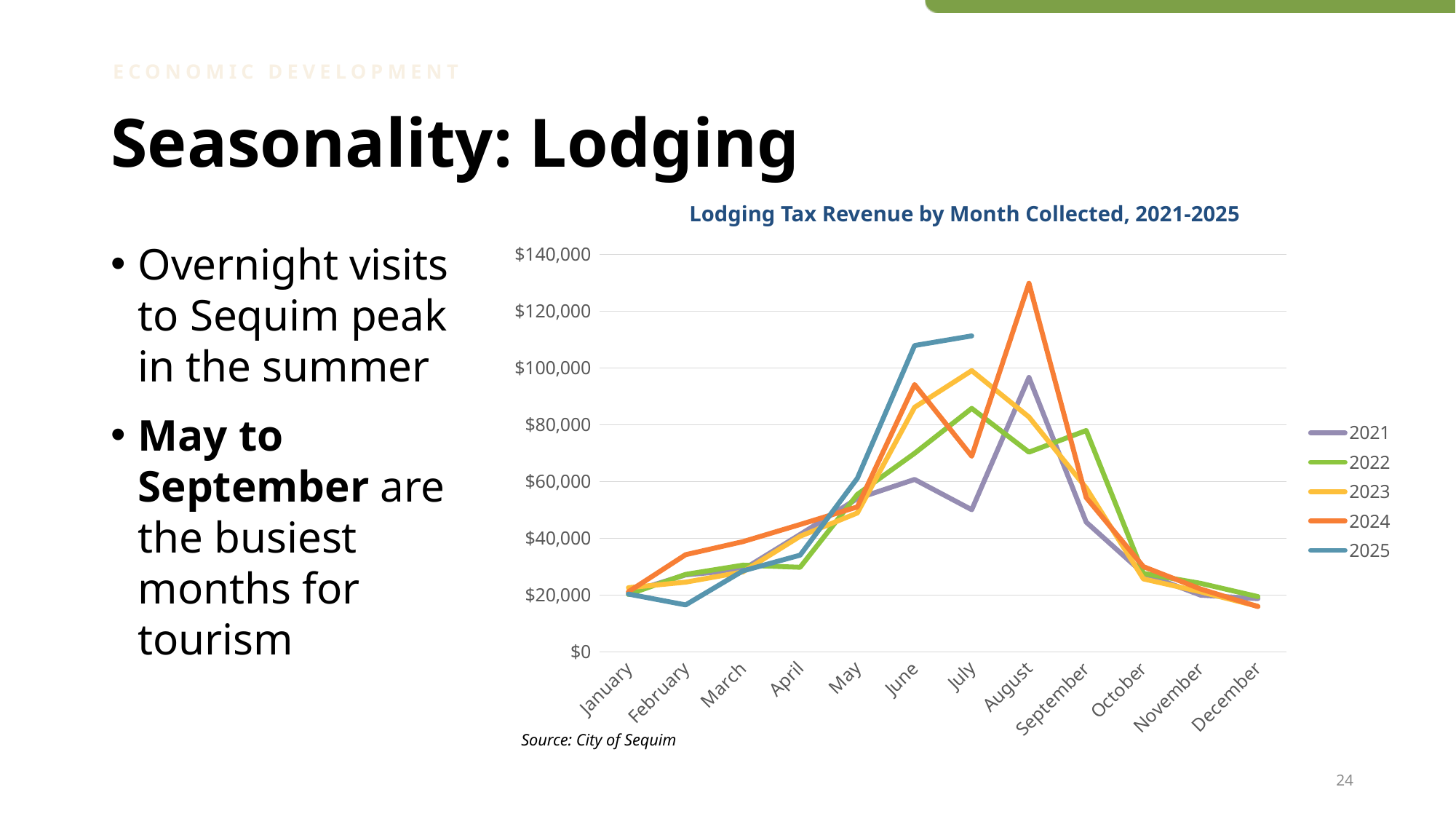
Is the value for 2025 in February greater or less than $20,000? less What kind of chart is shown on the slide? line chart Is the value for 2024 in August greater or less than $120,000? greater Is the value for 2021 in August greater or less than $80,000? greater How many series does the legend list? 5 How many months are shown along the x axis? 12 In which month is the 2025 series at its lowest? February What is the title of the chart? Lodging Tax Revenue by Month Collected, 2021-2025 Which year's series reaches the highest value on the chart? 2024 Do the values for the 2024 series rise or fall from August to December? fall In which month does the 2024 series reach its highest value? August